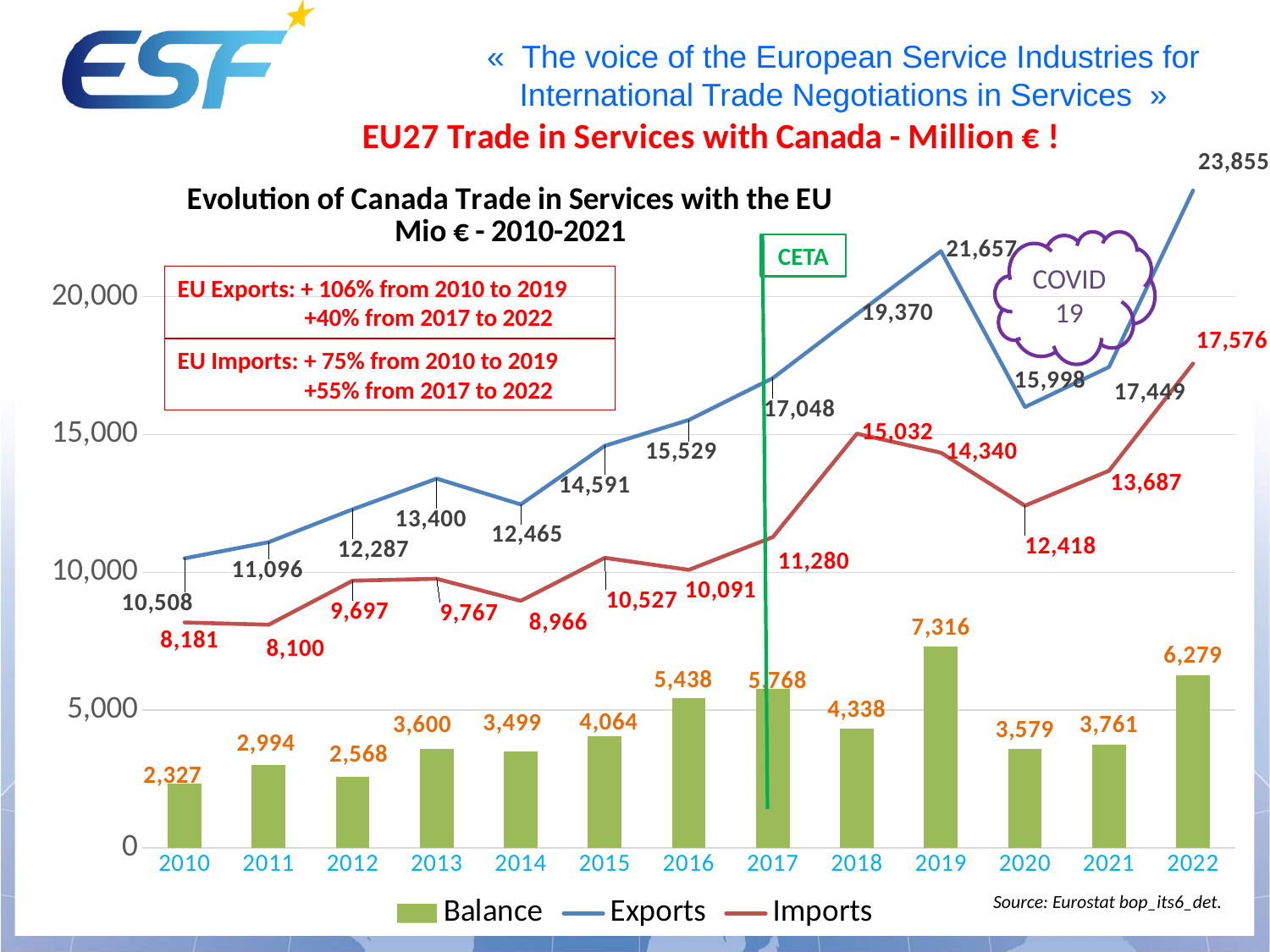
What is the value of Imports in 2020? 12,418 What is the Balance value for 2016? 5,438 Which is larger in 2018: Imports or the Balance? Imports Do Exports rise or fall from 2019 to 2020? fall How many series does the legend list? 3 How many years are shown on the x axis? 13 What is the value of Exports in 2019? 21,657 In which year are Exports highest? 2022 What is the difference between Exports and Imports in 2022? 6,279 In which year is the Balance lowest? 2010 Which series is shown as bars rather than lines? Balance In which year is the Balance highest? 2019